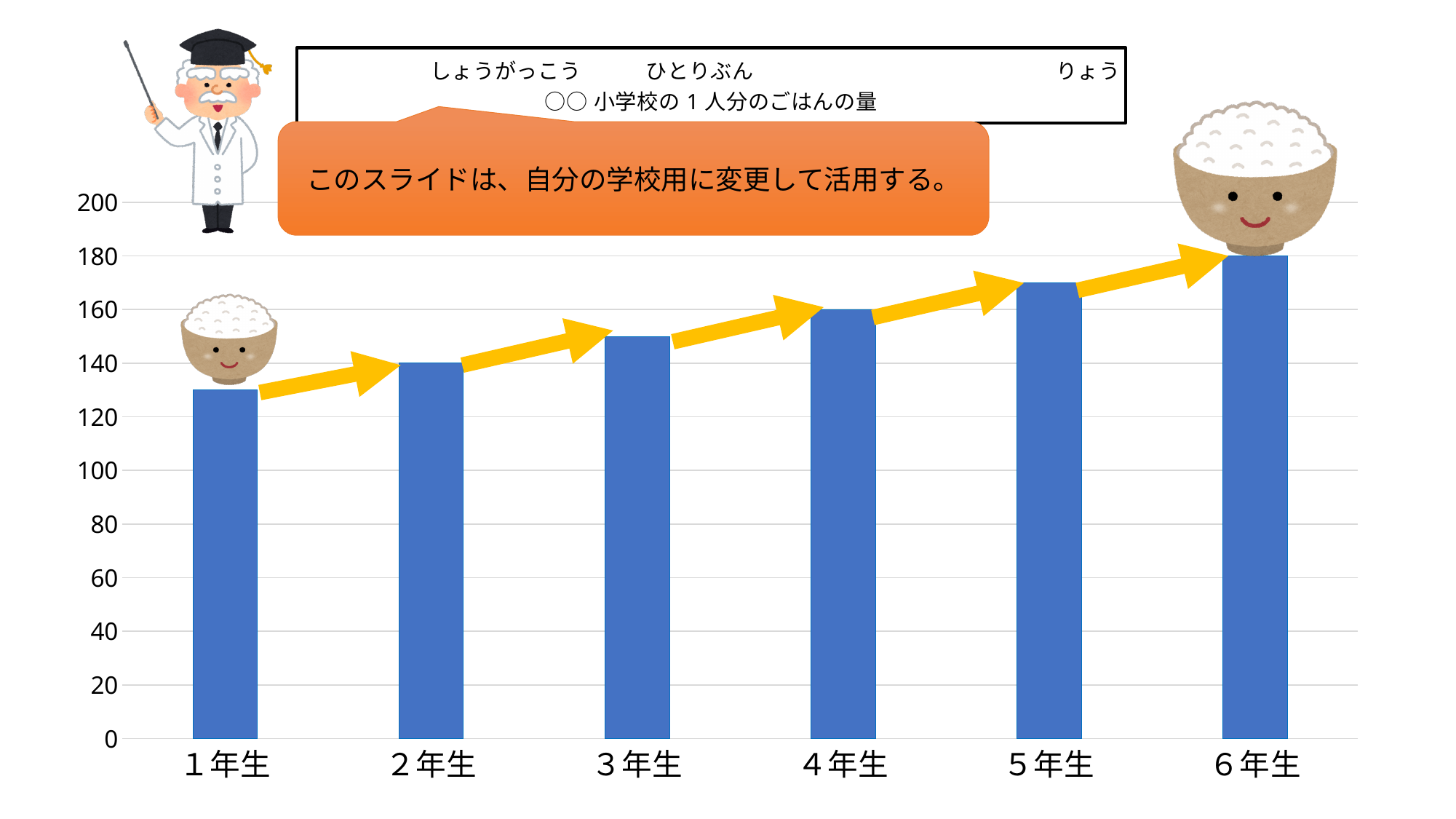
What is the value for ４年生? 160 Which grade has the lowest value? １年生 What is the value for ２年生? 140 Is the value for ３年生 greater or less than 140? greater How many grade categories are shown on the x axis? 6 Is the value for ５年生 greater or less than 180? less What kind of chart is shown on the slide? Bar chart What is the difference between the values for ６年生 and ２年生? 40 Which grade has the highest value? ６年生 What is the value for ６年生? 180 Is the value for １年生 greater or less than 140? less Do the values rise or fall from １年生 to ６年生? Rise